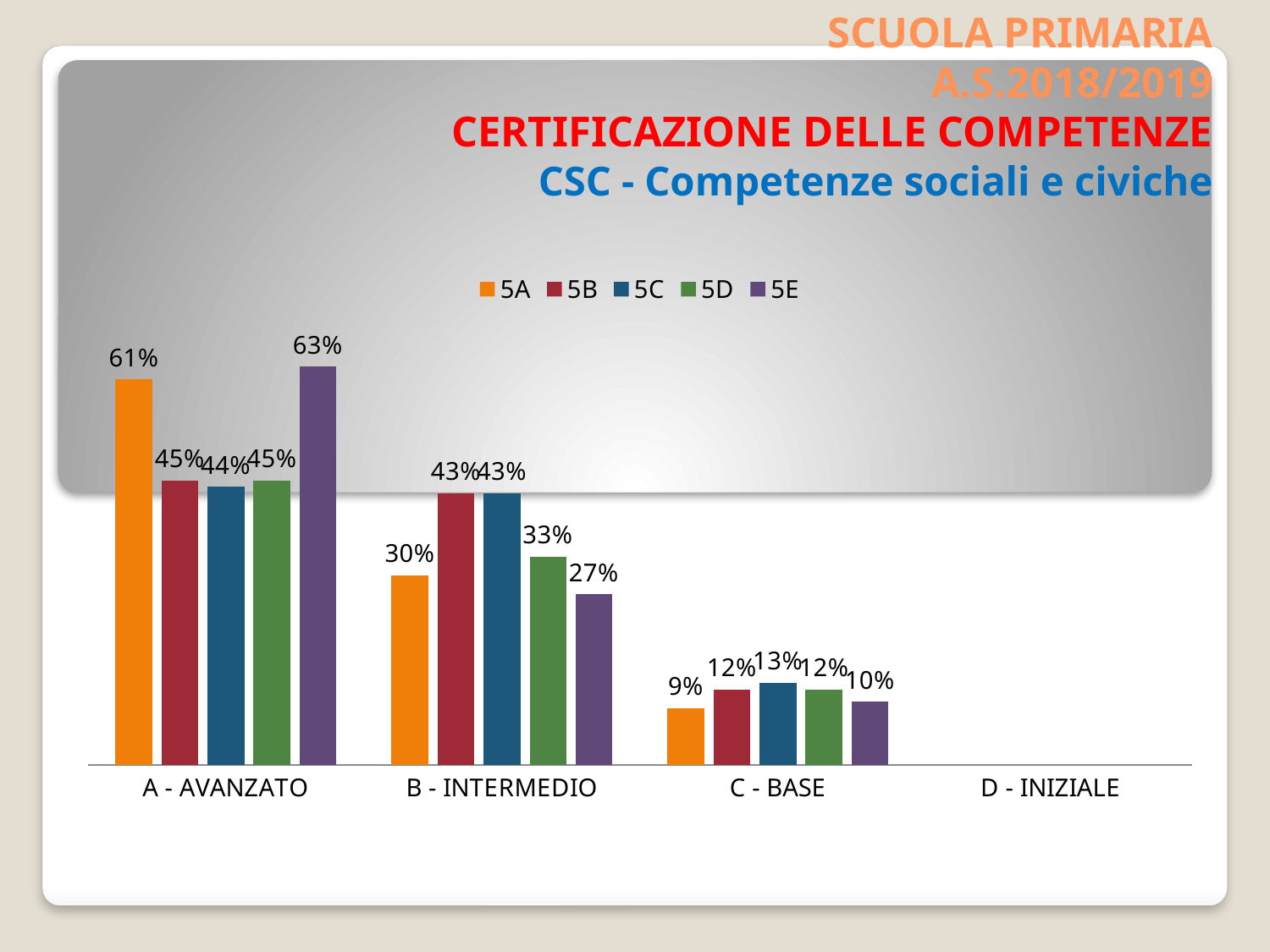
What is the value for 5E in the B - INTERMEDIO category? 27% What is the difference between the 5B and 5A values in the B - INTERMEDIO category? 13% What is the value for 5A in the A - AVANZATO category? 61% Which category has no bars plotted? D - INIZIALE What is the difference between the 5E and 5A values in the A - AVANZATO category? 2% Which series has the lowest value in the C - BASE category? 5A Which series has the highest value in the A - AVANZATO category? 5E What is the value for 5C in the C - BASE category? 13% How many series does the legend list? 5 How many categories are shown on the x axis? 4 What kind of chart is shown on the slide? bar chart Which is larger in the B - INTERMEDIO category: the value for 5B or the value for 5D? 5B